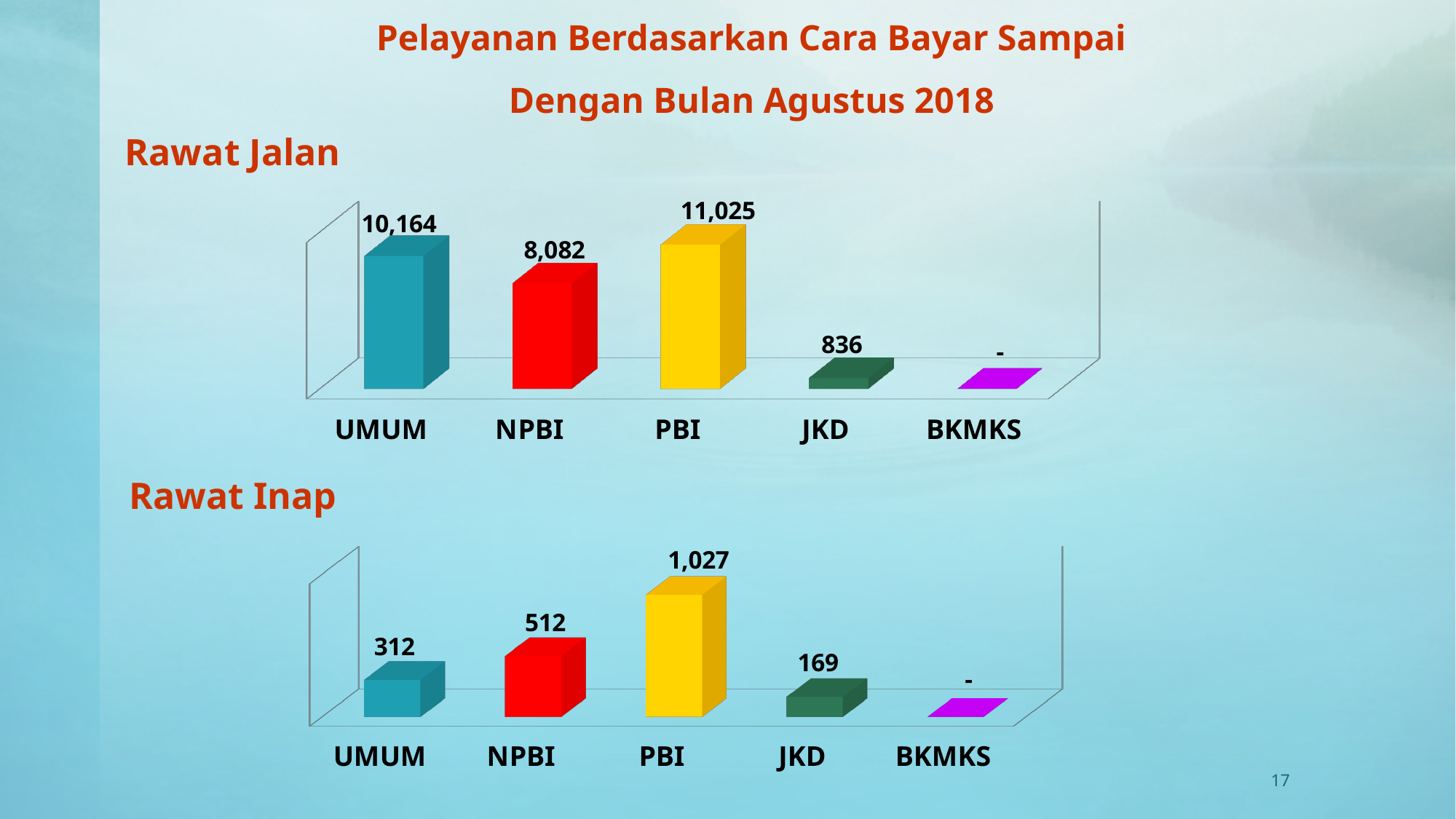
In the Rawat Inap chart, what is the value for NPBI? 512 In the Rawat Inap chart, what is the difference between the values for NPBI and UMUM? 200 What kind of chart is the Rawat Jalan chart? Bar chart In the Rawat Inap chart, which category with a printed value has the lowest value? JKD In the Rawat Jalan chart, which category has the highest value? PBI In the Rawat Jalan chart, which is larger, the value for UMUM or the value for NPBI? UMUM In the Rawat Jalan chart, what is the value for UMUM? 10,164 How many categories are shown on the x axis of the Rawat Inap chart? 5 In the Rawat Jalan chart, what is the value for JKD? 836 In the Rawat Inap chart, what is the value for PBI? 1,027 What colour is the PBI bar in the Rawat Inap chart? Yellow In the Rawat Jalan chart, what is the difference between the values for PBI and NPBI? 2,943